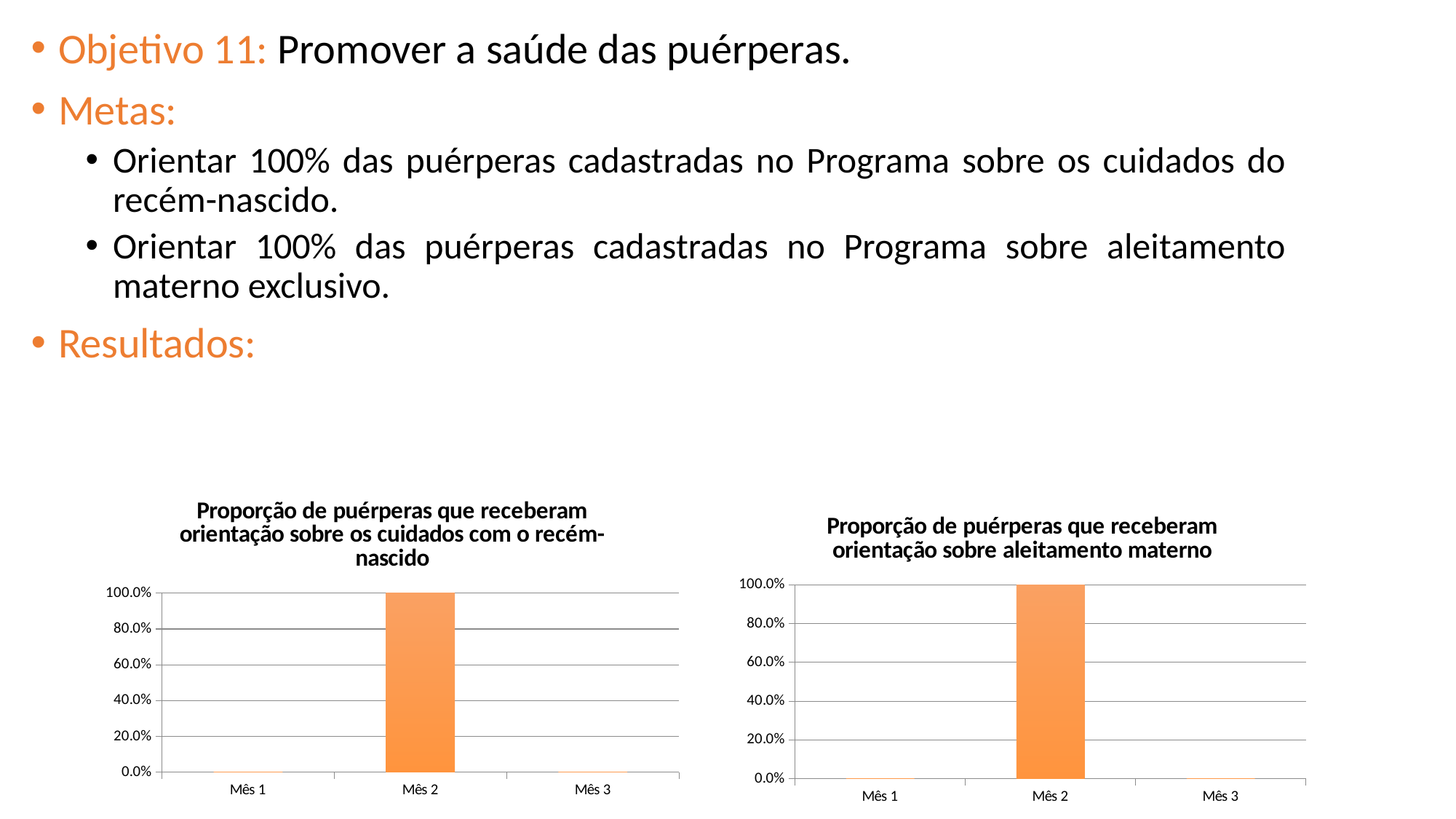
In the left chart, which month has the highest value? Mês 2 In the right chart (Proporção de puérperas que receberam orientação sobre aleitamento materno), what is the value for Mês 2? 100.0% In the right chart, which month has the highest value? Mês 2 In the left chart (Proporção de puérperas que receberam orientação sobre os cuidados com o recém-nascido), what is the value for Mês 2? 100.0% In the left chart, is the value for Mês 2 greater or less than 80.0%? greater How many categories are shown on the x axis of the left chart? 3 In the left chart, what is the value for Mês 1? 0.0% What is the title of the right chart? Proporção de puérperas que receberam orientação sobre aleitamento materno In the right chart, which is larger, the value for Mês 2 or the value for Mês 3? Mês 2 What kind of chart is the right chart? Bar chart In the right chart, is the value for Mês 1 greater or less than 20.0%? less In the right chart, what is the value for Mês 3? 0.0%